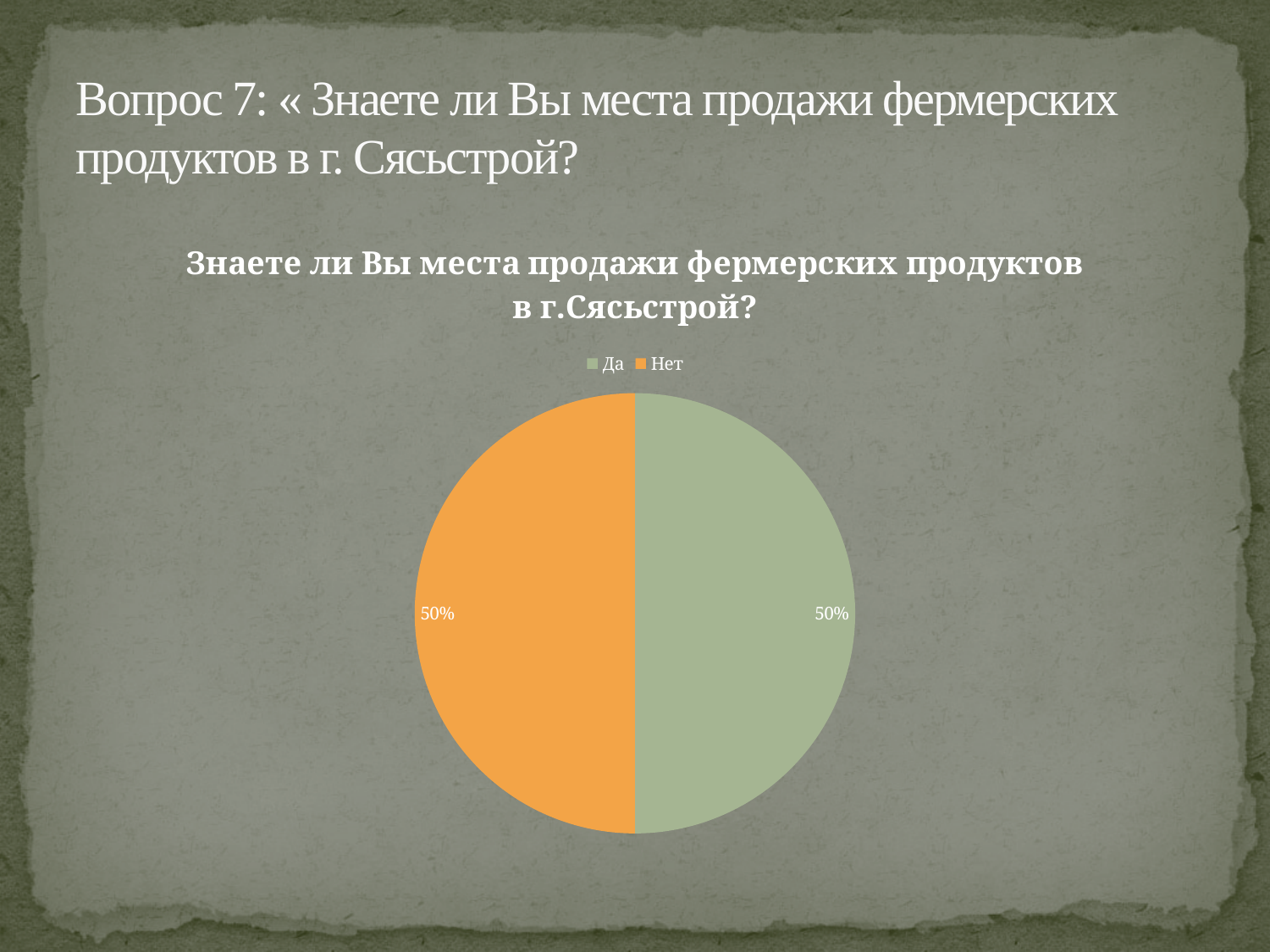
What is the title of the chart? Знаете ли Вы места продажи фермерских продуктов в г.Сясьстрой? What is the difference between the "Да" and "Нет" shares? 0% What kind of chart is shown on the slide? pie chart How many slices does the pie chart have? 2 Which legend entry is shown in orange? Нет What share of the pie does the "Да" slice represent? 50% How many entries does the legend list? 2 What share of the pie does the "Нет" slice represent? 50% What is the total of the two slices' percentages? 100%